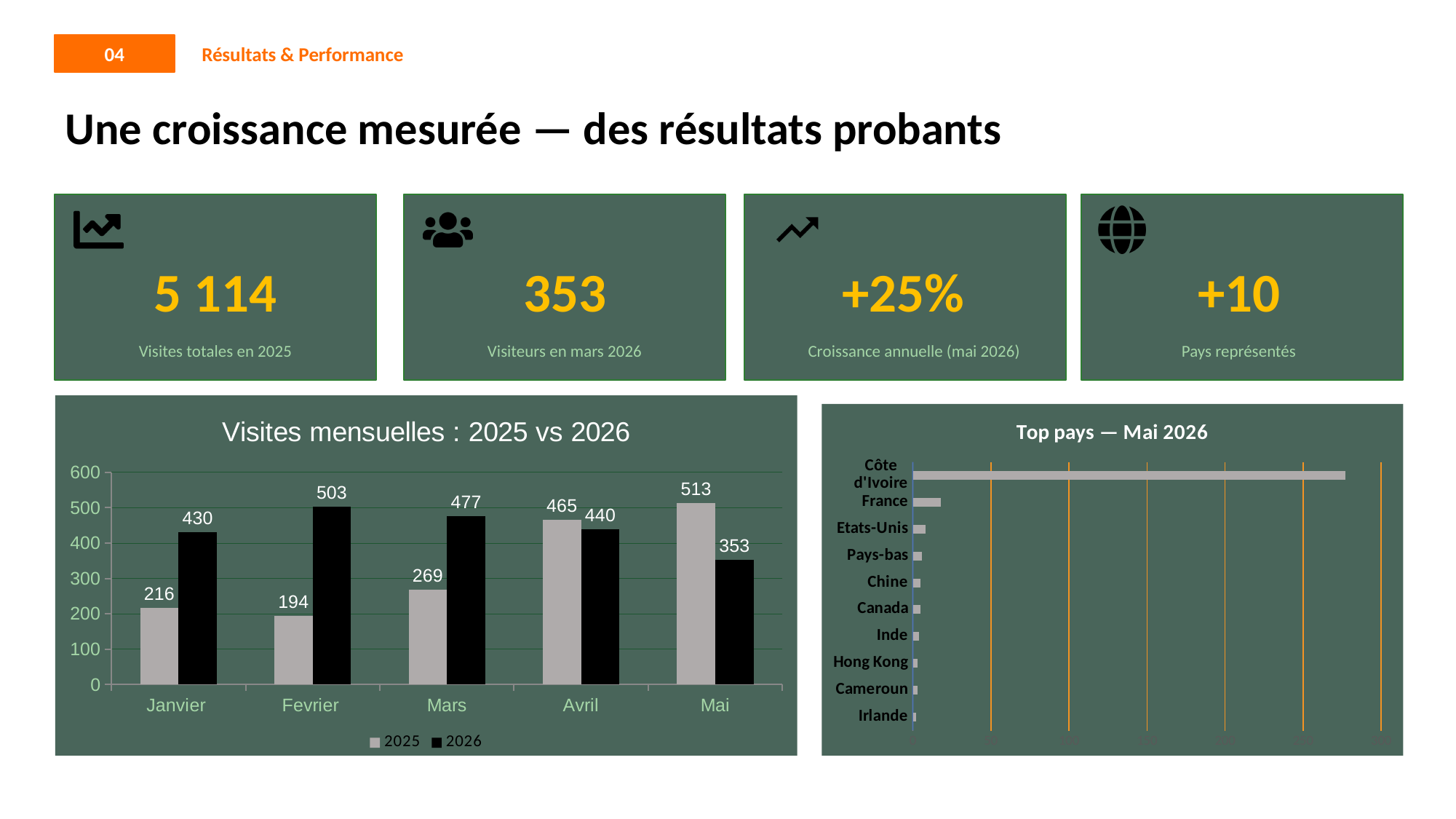
In the 'Visites mensuelles : 2025 vs 2026' chart, what is the value for Fevrier in 2025? 194 In the 'Visites mensuelles : 2025 vs 2026' chart, how many series does the legend list? 2 In the 'Visites mensuelles : 2025 vs 2026' chart, how many months are shown on the x axis? 5 In the 'Top pays — Mai 2026' chart, which country has the highest value? Côte d'Ivoire In the 'Visites mensuelles : 2025 vs 2026' chart, what is the value for Mars in 2026? 477 In the 'Top pays — Mai 2026' chart, how many countries are listed? 10 In the 'Visites mensuelles : 2025 vs 2026' chart, which is larger for Avril: the 2025 value or the 2026 value? 2025 In the 'Visites mensuelles : 2025 vs 2026' chart, which month has the lowest 2026 value? Mai What kind of chart is 'Top pays — Mai 2026'? bar chart In the 'Visites mensuelles : 2025 vs 2026' chart, what is the difference between the 2026 and 2025 values for Janvier? 214 In the 'Visites mensuelles : 2025 vs 2026' chart, which month has the highest 2025 value? Mai In the 'Visites mensuelles : 2025 vs 2026' chart, do the 2025 values rise or fall from Mars to Mai? rise